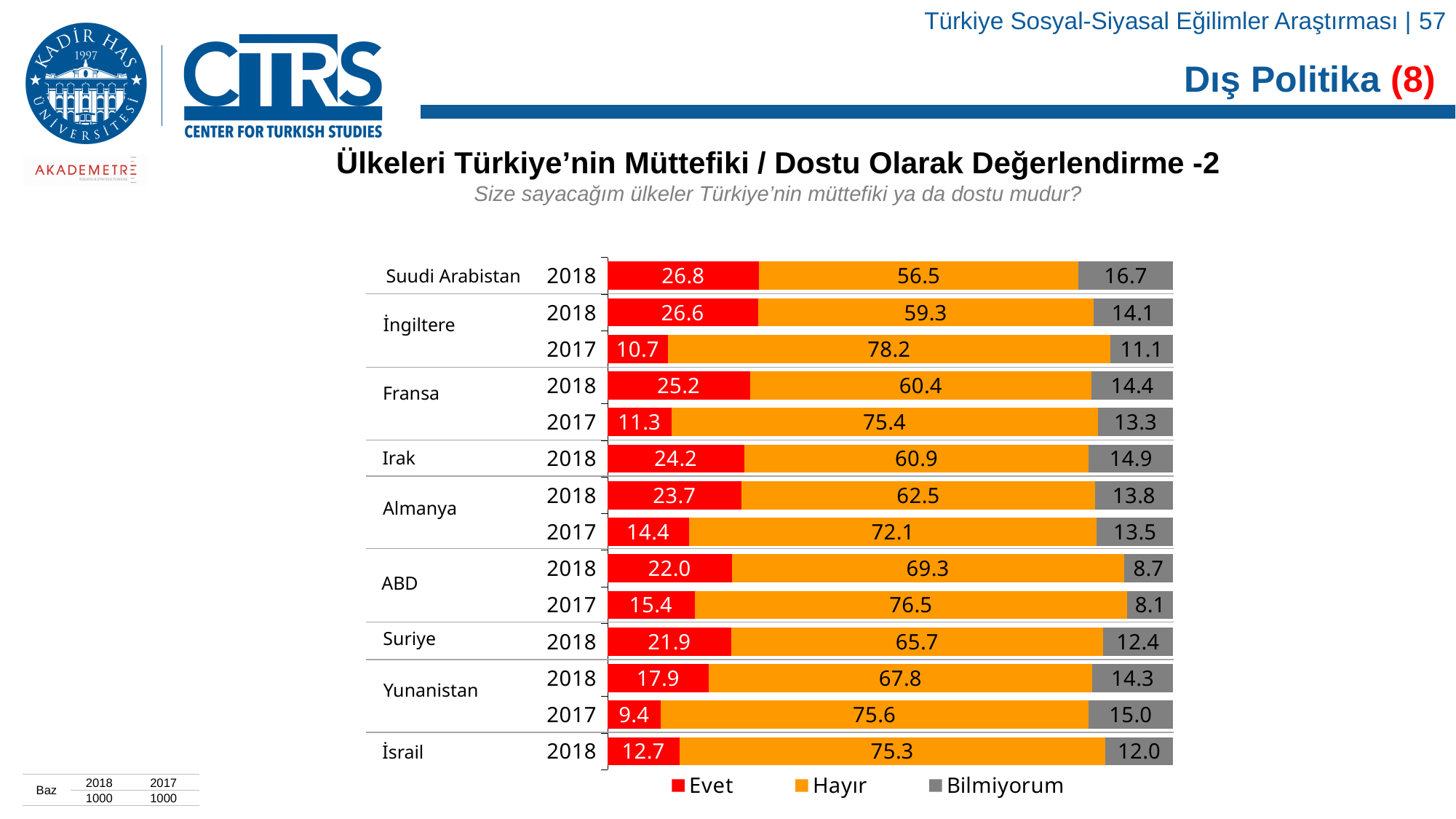
What is the total of the stacked bar for İsrail in 2018? 100.0 How many series does the legend list? 3 Which bar has the highest Hayır value? İngiltere 2017 What is the difference between the Evet values for Fransa in 2018 and 2017? 13.9 What kind of chart is shown on the slide? Stacked bar chart Which is larger, the Evet value for Almanya in 2018 or for Yunanistan in 2018? Almanya 2018 What is the Bilmiyorum value for ABD in 2018? 8.7 What is the Hayır value for İngiltere in 2017? 78.2 How many bars are plotted in the chart? 14 Which bar has the lowest Bilmiyorum value? ABD 2017 What is the Evet value for Suudi Arabistan in 2018? 26.8 Which colour represents the Hayır series in the legend? Orange